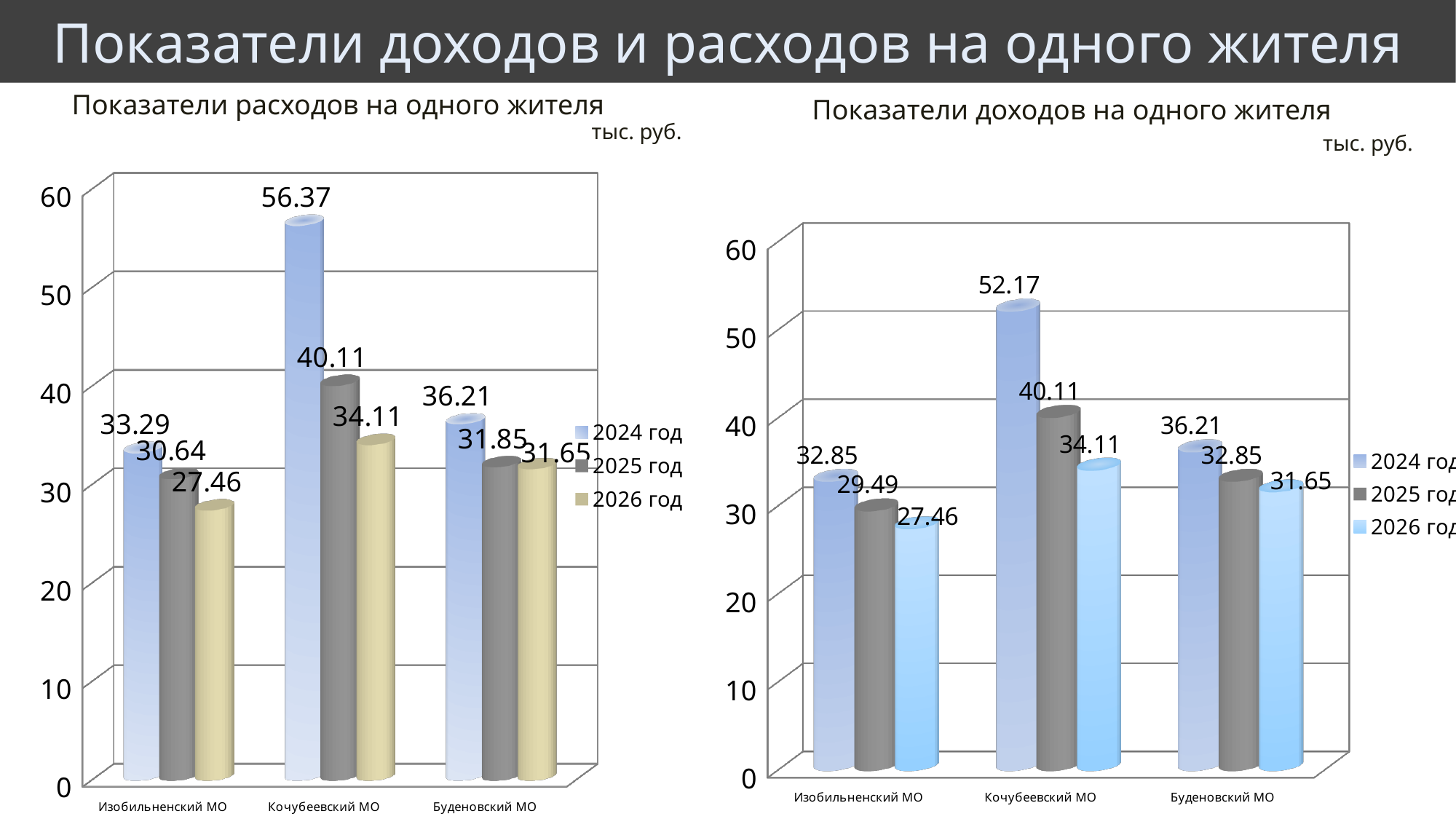
On the chart 'Показатели расходов на одного жителя', which category has the lowest value for 2026 год? Изобильненский МО On the chart 'Показатели доходов на одного жителя', what is the value for Изобильненский МО in 2025 год? 29.49 How many series does the legend list on the chart 'Показатели доходов на одного жителя'? 3 What kind of chart is 'Показатели расходов на одного жителя'? bar chart On the chart 'Показатели расходов на одного жителя', what is the value for Буденовский МО in 2026 год? 31.65 On the chart 'Показатели расходов на одного жителя', which is larger: the 2024 год value for Изобильненский МО or the 2024 год value for Буденовский МО? Буденовский МО On the chart 'Показатели доходов на одного жителя', which category has the highest value for 2024 год? Кочубеевский МО On the chart 'Показатели доходов на одного жителя', what is the difference between the 2024 год and 2025 год values for Кочубеевский МО? 12.06 On the chart 'Показатели доходов на одного жителя', do the values for Буденовский МО rise or fall from 2024 год to 2026 год? fall On the chart 'Показатели расходов на одного жителя', what is the value for Кочубеевский МО in 2024 год? 56.37 How many categories are shown on the chart 'Показатели расходов на одного жителя'? 3 On the chart 'Показатели доходов на одного жителя', is the 2024 год value for Кочубеевский МО greater or less than 50? greater